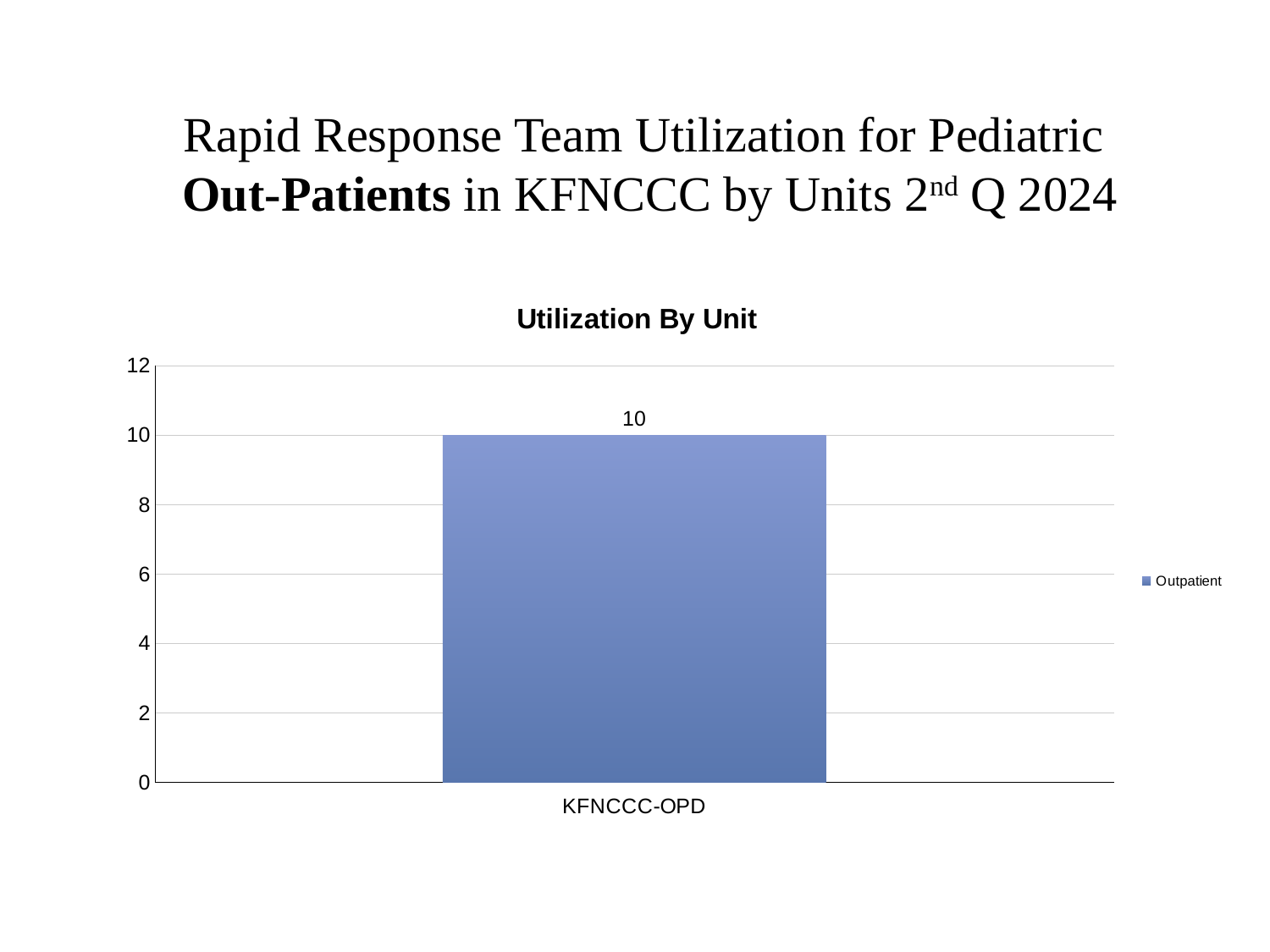
Is the value for KFNCCC-OPD greater or less than 8? greater How many series does the legend of the Utilization By Unit chart list? 1 Is the value for KFNCCC-OPD greater or less than 12? less What is the label of the only category on the x axis of the Utilization By Unit chart? KFNCCC-OPD What is the title of the chart on the slide? Utilization By Unit What kind of chart is the Utilization By Unit chart? bar chart What series name is shown in the legend of the Utilization By Unit chart? Outpatient What is the highest value shown on the y axis of the Utilization By Unit chart? 12 How many categories are shown on the x axis of the Utilization By Unit chart? 1 What is the value for KFNCCC-OPD in the Utilization By Unit chart? 10